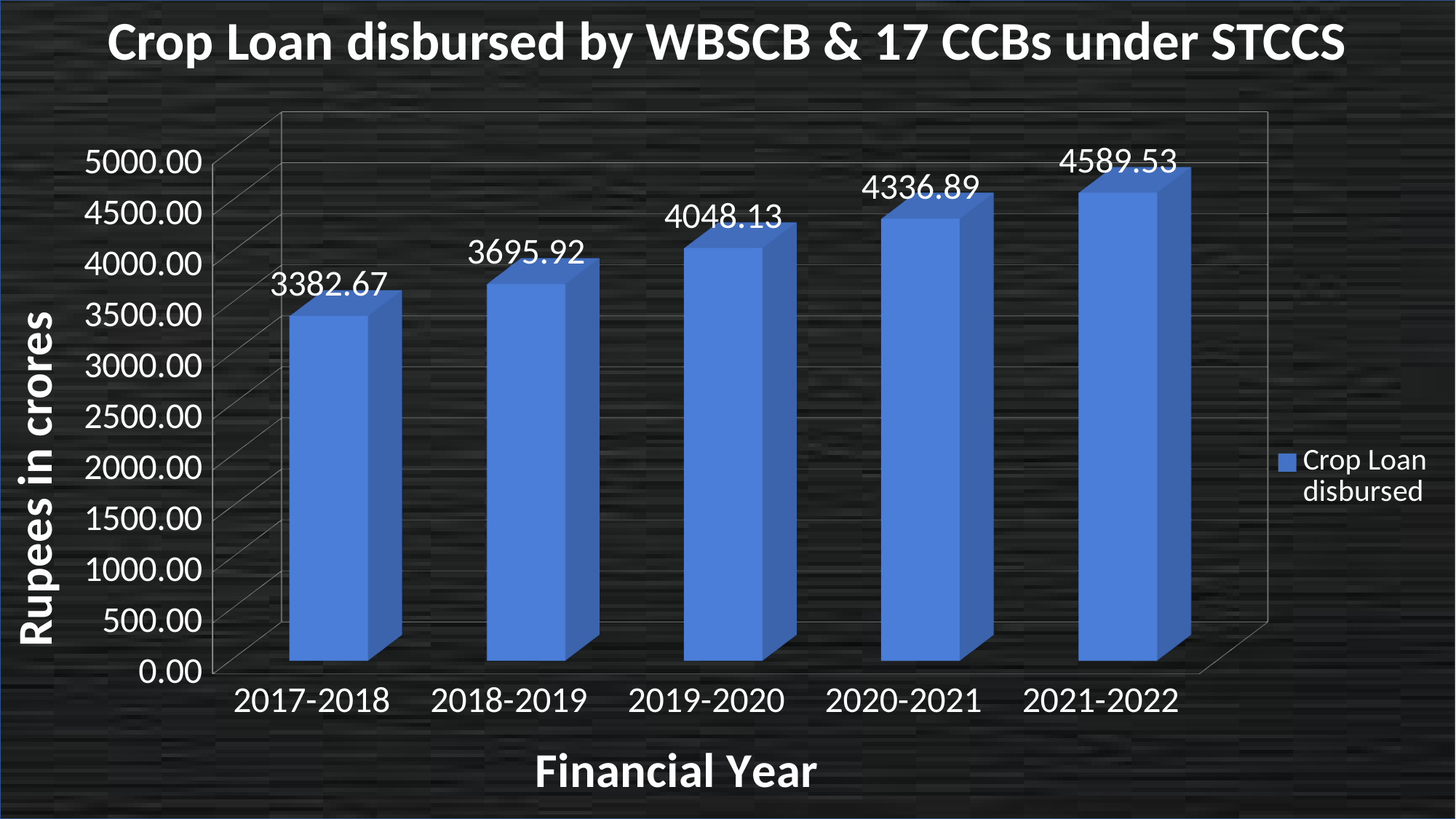
What kind of chart is shown on the slide? Bar chart What was the crop loan disbursed in 2021-2022? 4589.53 Which financial year had the highest crop loan disbursed? 2021-2022 Do the crop loan values rise or fall from 2017-2018 to 2021-2022? Rise What is the difference between the crop loan disbursed in 2018-2019 and in 2017-2018? 313.25 Which year had a larger crop loan disbursed, 2018-2019 or 2020-2021? 2020-2021 What was the crop loan disbursed in 2017-2018? 3382.67 Is the value for 2019-2020 greater or less than 4000.00? greater What is the difference between the crop loan disbursed in 2021-2022 and in 2020-2021? 252.64 How many financial years are shown on the chart? 5 What was the crop loan disbursed in 2019-2020? 4048.13 Which financial year had the lowest crop loan disbursed? 2017-2018